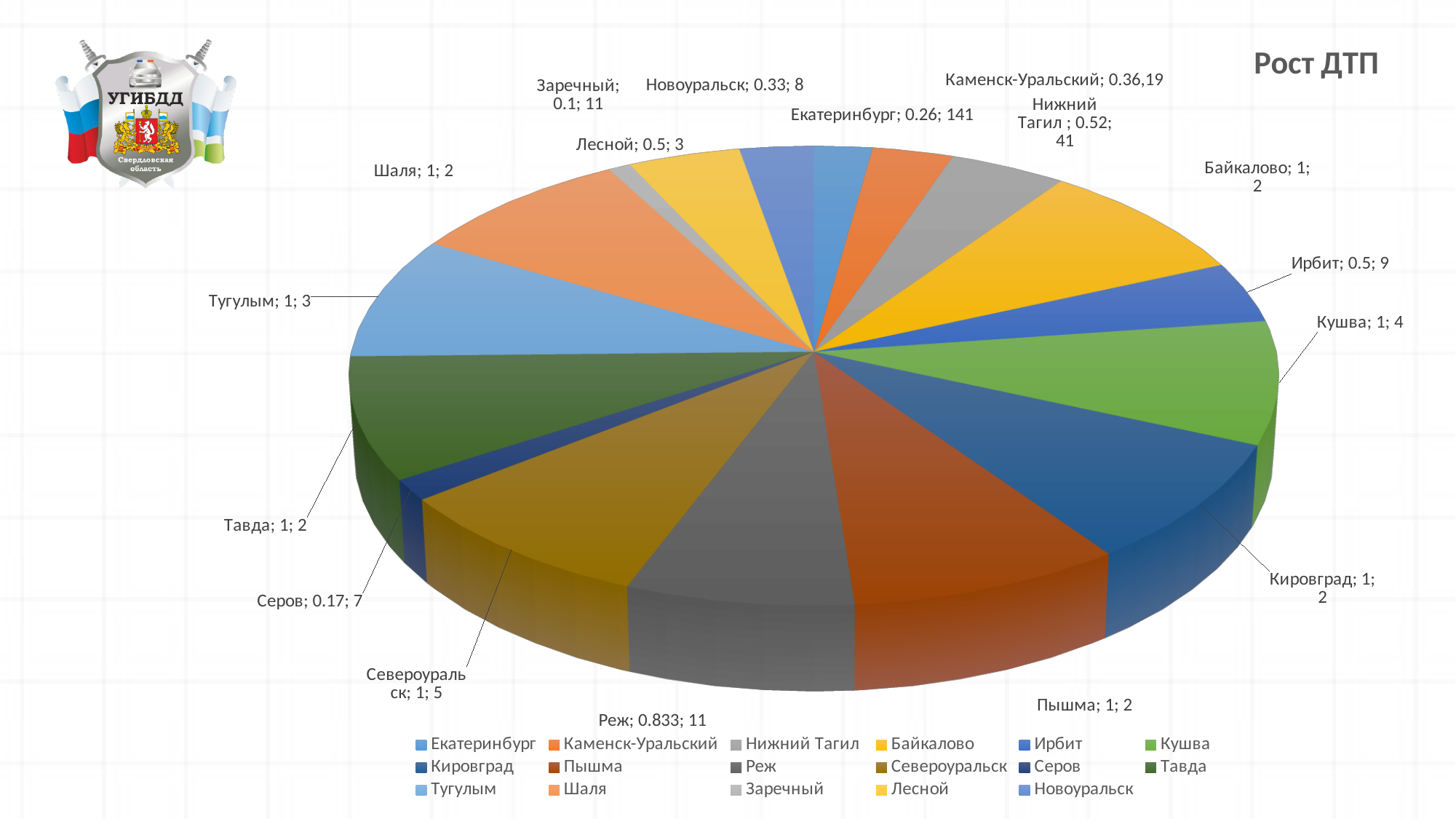
How many categories does the legend of the pie chart list? 17 What values are printed in the data label for Реж? 0.833; 11 What is the title of the chart? Рост ДТП Which category has the smallest first value in its data label (the smallest slice)? Заречный What values are printed in the data label for Нижний Тагил? 0.52; 41 Which category has the largest second value in its data label? Екатеринбург What is the difference between the second label value for Екатеринбург (141) and for Нижний Тагил (41)? 100 What values are printed in the data label for Екатеринбург? 0.26; 141 What values are printed in the data label for Заречный? 0.1; 11 What values are printed in the data label for Серов? 0.17; 7 Which has the larger first label value, Реж or Серов? Реж What type of chart is shown on the slide? pie chart